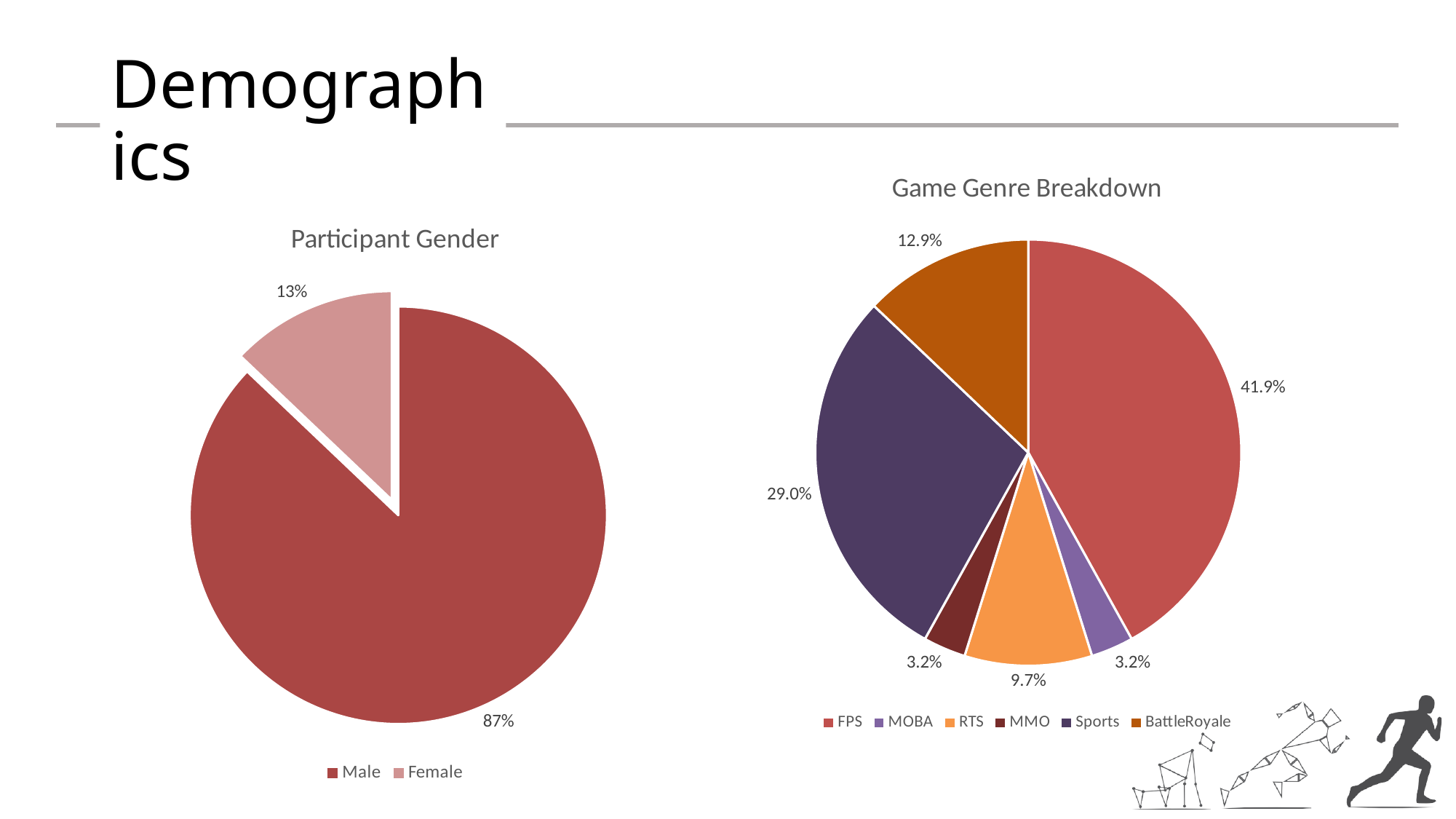
In the Game Genre Breakdown chart, what is the difference between the FPS share and the Sports share? 12.9% In the Game Genre Breakdown chart, how many genres are shown in the legend? 6 In the Game Genre Breakdown chart, what share does BattleRoyale have? 12.9% In the Game Genre Breakdown chart, which genre has the largest share? FPS What kind of chart is the Game Genre Breakdown chart? Pie chart In the Game Genre Breakdown chart, which is larger, the share for Sports or the share for BattleRoyale? Sports In the Participant Gender chart, what percentage of participants are Male? 87% In the Game Genre Breakdown chart, what share does RTS have? 9.7% In the Game Genre Breakdown chart, what share does FPS have? 41.9% In the Participant Gender chart, what percentage of participants are Female? 13% In the Participant Gender chart, what is the difference between the Male and Female shares? 74% In the Game Genre Breakdown chart, what share does Sports have? 29.0%